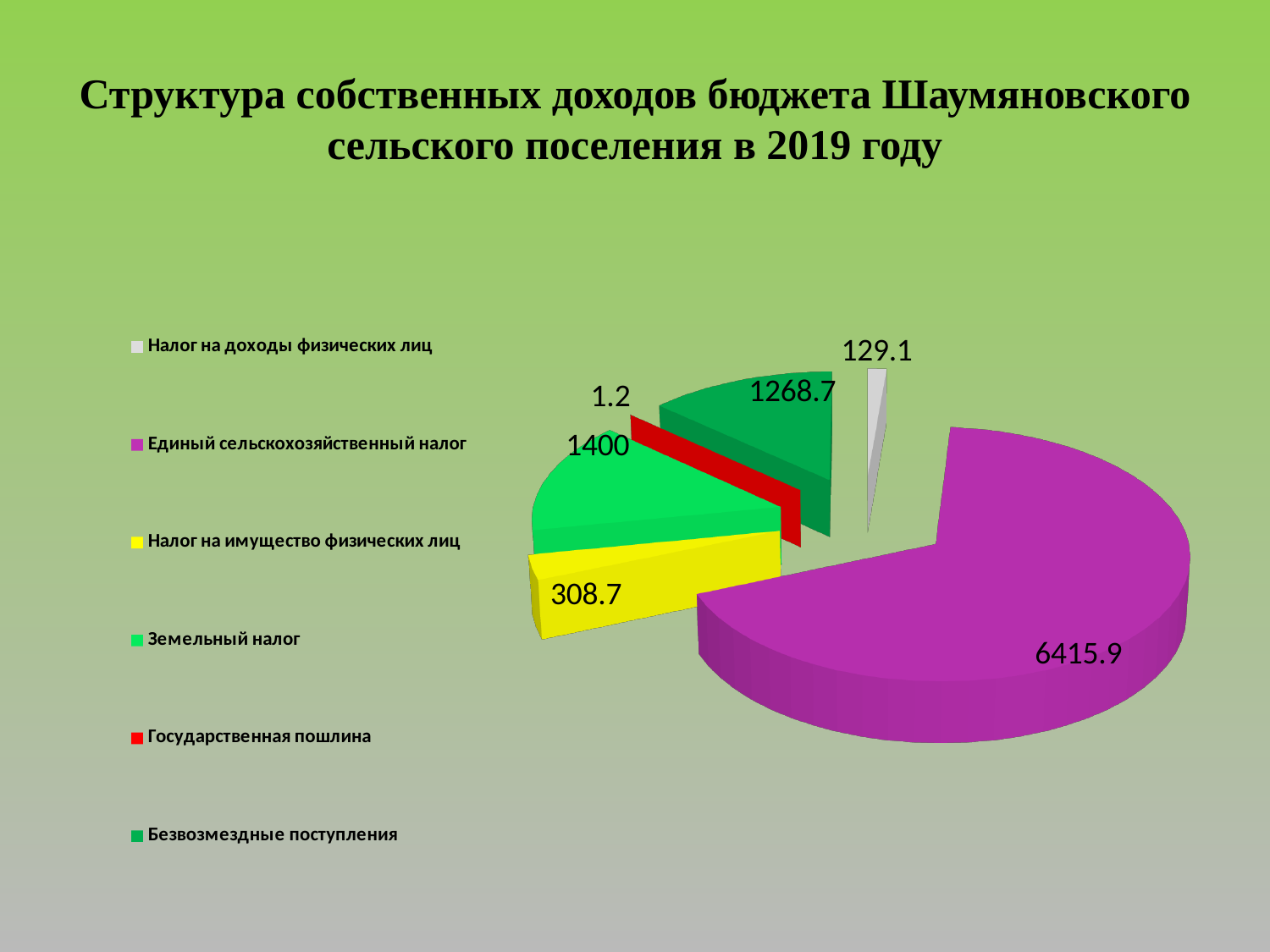
How many categories are shown in the pie chart? 6 What is the value for Земельный налог? 1400 What is the value for Налог на имущество физических лиц? 308.7 Which category has the largest slice of the pie? Единый сельскохозяйственный налог What is the value for Государственная пошлина? 1.2 Which is larger: Налог на имущество физических лиц or Налог на доходы физических лиц? Налог на имущество физических лиц Which category has the smallest slice of the pie? Государственная пошлина What kind of chart is shown on the slide? Pie chart What is the value for Безвозмездные поступления? 1268.7 What is the difference between the values for Земельный налог and Безвозмездные поступления? 131.3 What is the value for Единый сельскохозяйственный налог? 6415.9 What colour is the slice for Единый сельскохозяйственный налог? Magenta (purple)